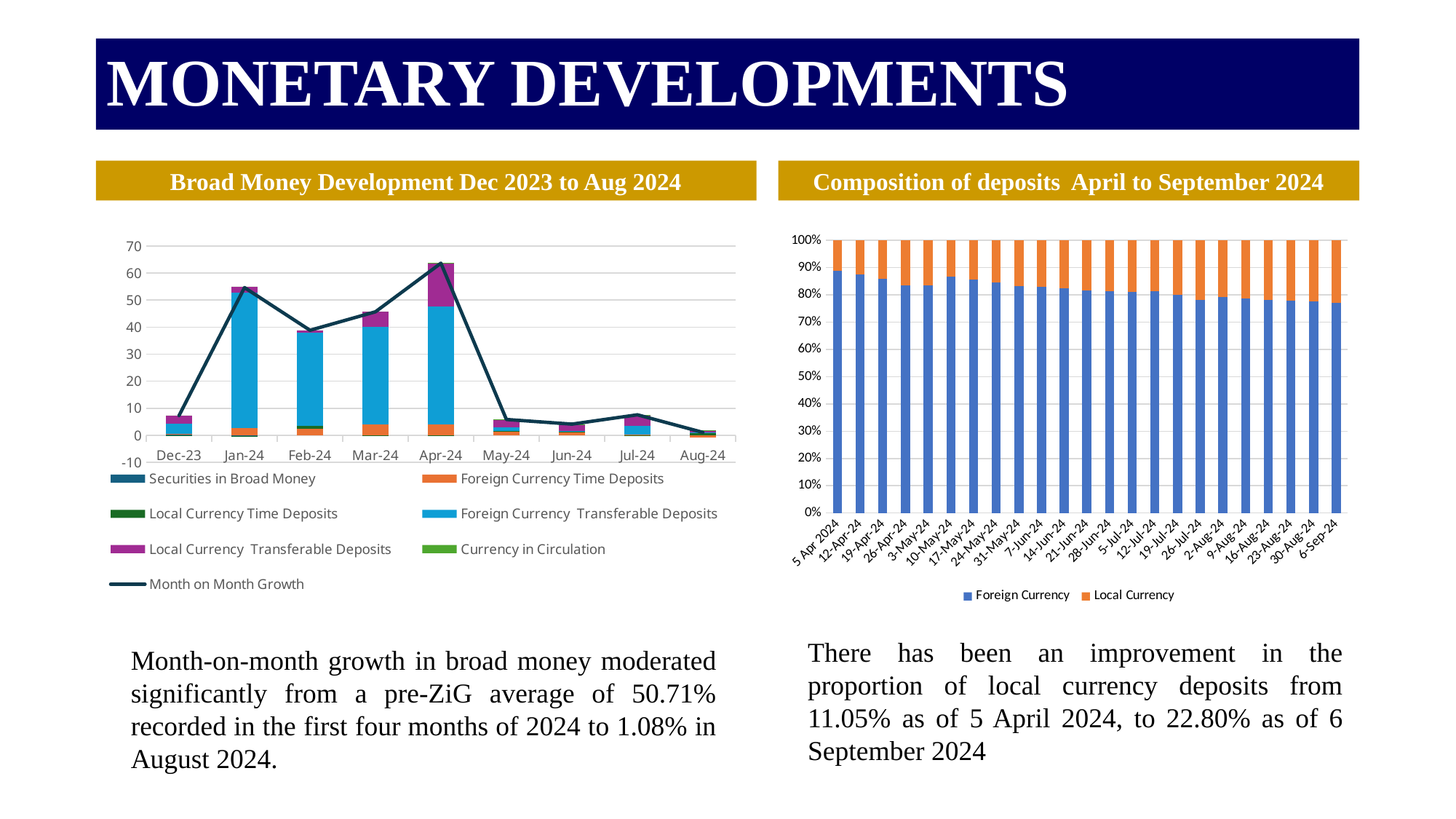
How many months are shown on the x axis of the 'Broad Money Development Dec 2023 to Aug 2024' chart? 9 In the 'Broad Money Development Dec 2023 to Aug 2024' chart, is the total stacked bar for Jan-24 larger or smaller than the total for Feb-24? larger How many series does the legend of the 'Composition of deposits April to September 2024' chart list? 2 How many series does the legend of the 'Broad Money Development Dec 2023 to Aug 2024' chart list? 7 In the 'Composition of deposits April to September 2024' chart, is the Foreign Currency share on 6-Sep-24 greater or less than 80%? less How many dates are shown on the x axis of the 'Composition of deposits April to September 2024' chart? 23 In the 'Broad Money Development Dec 2023 to Aug 2024' chart, is the Month on Month Growth value for Jan-24 greater or less than 50? greater In the 'Composition of deposits April to September 2024' chart, does the Foreign Currency share generally rise or fall from 5 Apr 2024 to 6-Sep-24? fall In the 'Broad Money Development Dec 2023 to Aug 2024' chart, which month has the highest Month on Month Growth line value? Apr-24 In the 'Composition of deposits April to September 2024' chart, is the Foreign Currency share on 5 Apr 2024 greater or less than 80%? greater What kind of chart is the 'Composition of deposits April to September 2024' chart? bar chart In the 'Composition of deposits April to September 2024' chart, which colour represents Local Currency? orange